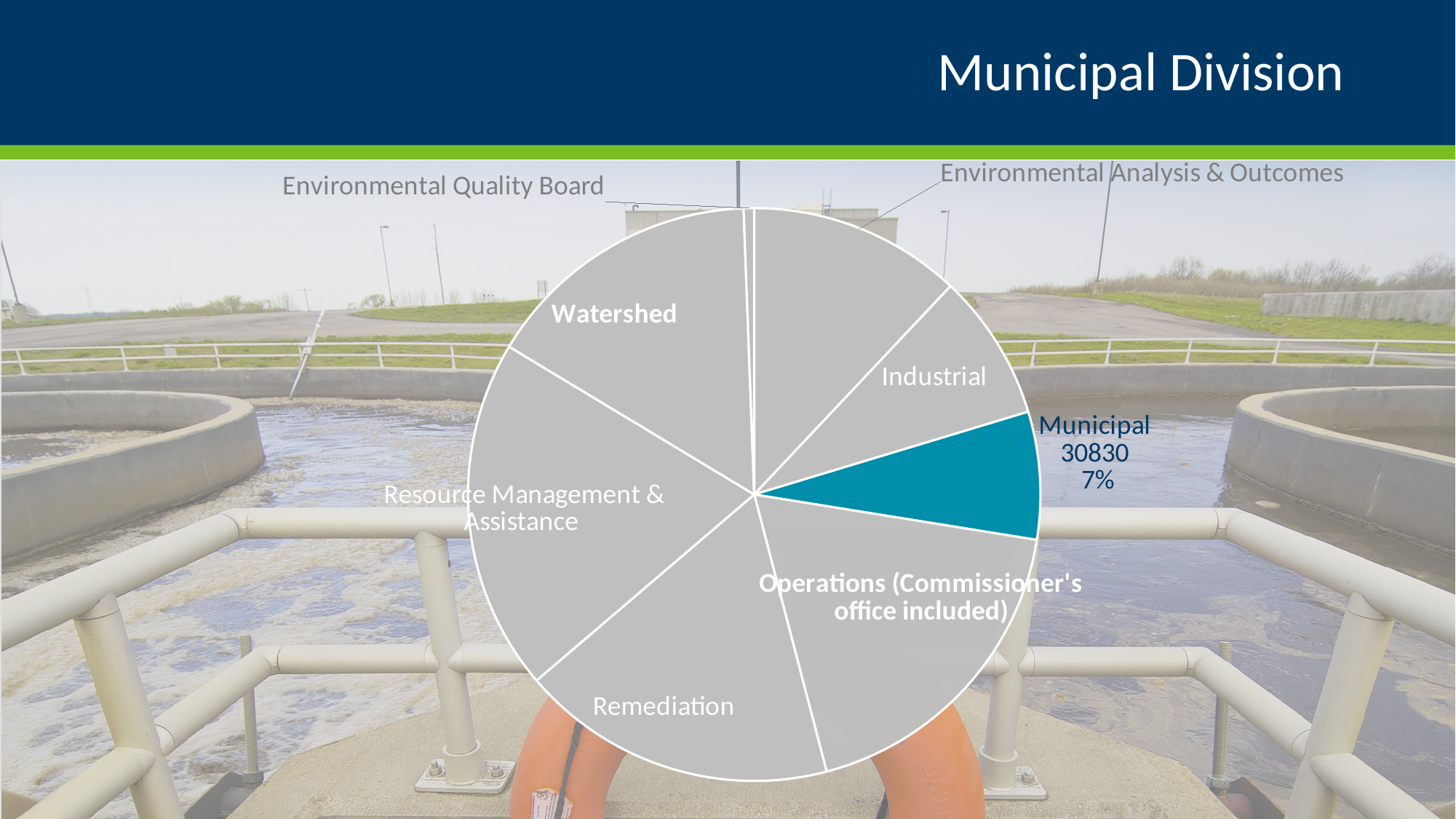
Which slice of the pie chart is the smallest? Environmental Quality Board Which is larger, the Watershed slice or the Municipal slice? Watershed Which is larger, the Environmental Quality Board slice or the Remediation slice? Remediation What value is shown for the Municipal slice? 30830 How many slices does the pie chart have? 8 Which is larger, the Municipal slice or the Operations (Commissioner's office included) slice? Operations (Commissioner's office included) Which slice of the pie chart is highlighted in teal rather than grey? Municipal What kind of chart is shown on the slide? pie chart What share of the pie does the Municipal slice represent? 7% What is the title of the slide containing the pie chart? Municipal Division